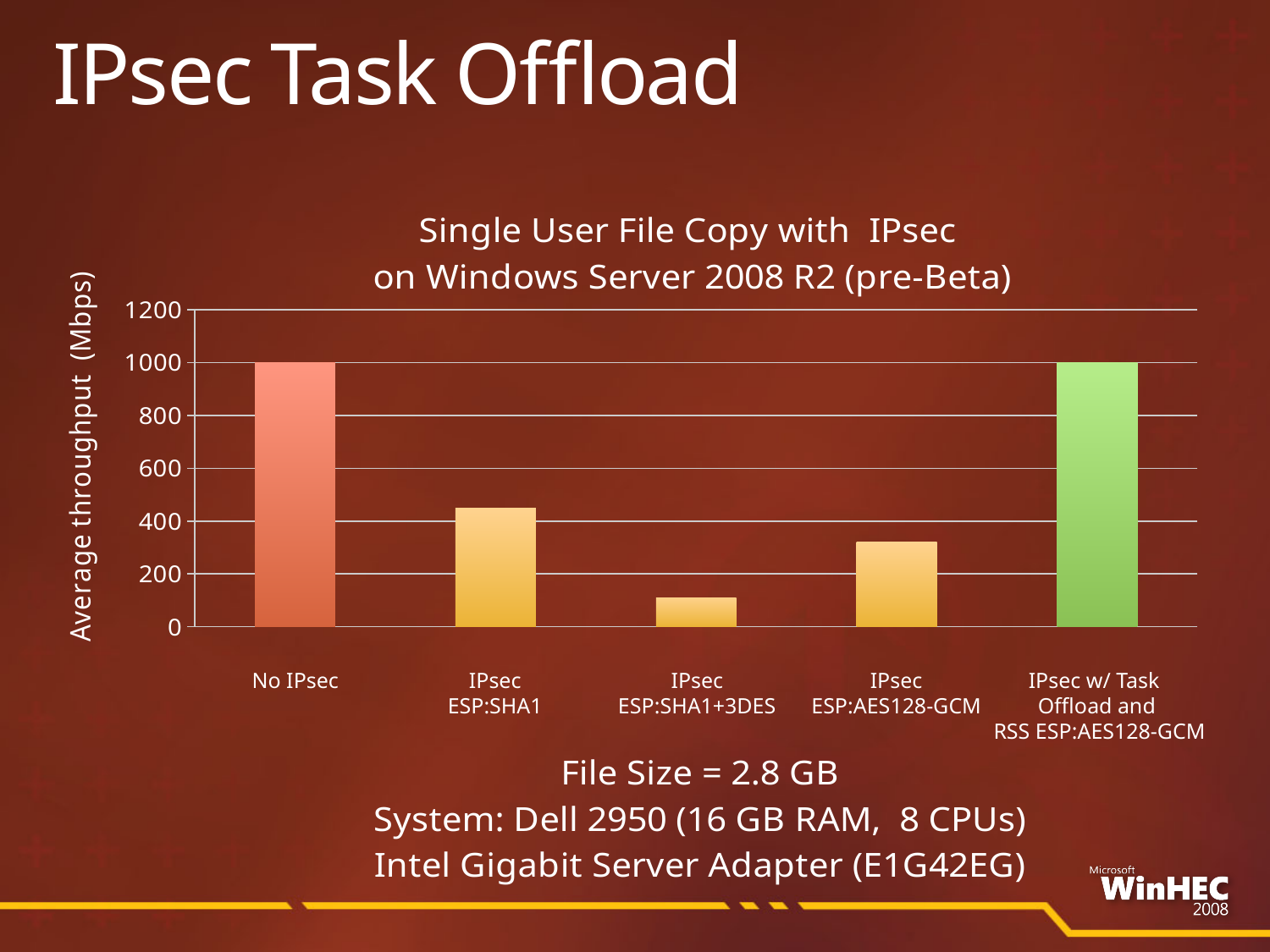
What is the label of the vertical axis of the chart? Average throughput (Mbps) Which category is shown with a green bar? IPsec w/ Task Offload and RSS ESP:AES128-GCM Is the value for IPsec ESP:AES128-GCM greater or less than 400? less Which category has the lowest average throughput? IPsec ESP:SHA1+3DES How many categories are plotted in the chart? 5 Which has the higher average throughput, IPsec ESP:SHA1+3DES or IPsec w/ Task Offload and RSS ESP:AES128-GCM? IPsec w/ Task Offload and RSS ESP:AES128-GCM What kind of chart is shown on the slide? Bar chart Which has the higher average throughput, IPsec ESP:SHA1 or IPsec ESP:AES128-GCM? IPsec ESP:SHA1 Is the value for IPsec ESP:SHA1+3DES greater or less than 200? less Is the value for IPsec ESP:SHA1 greater or less than 400? greater